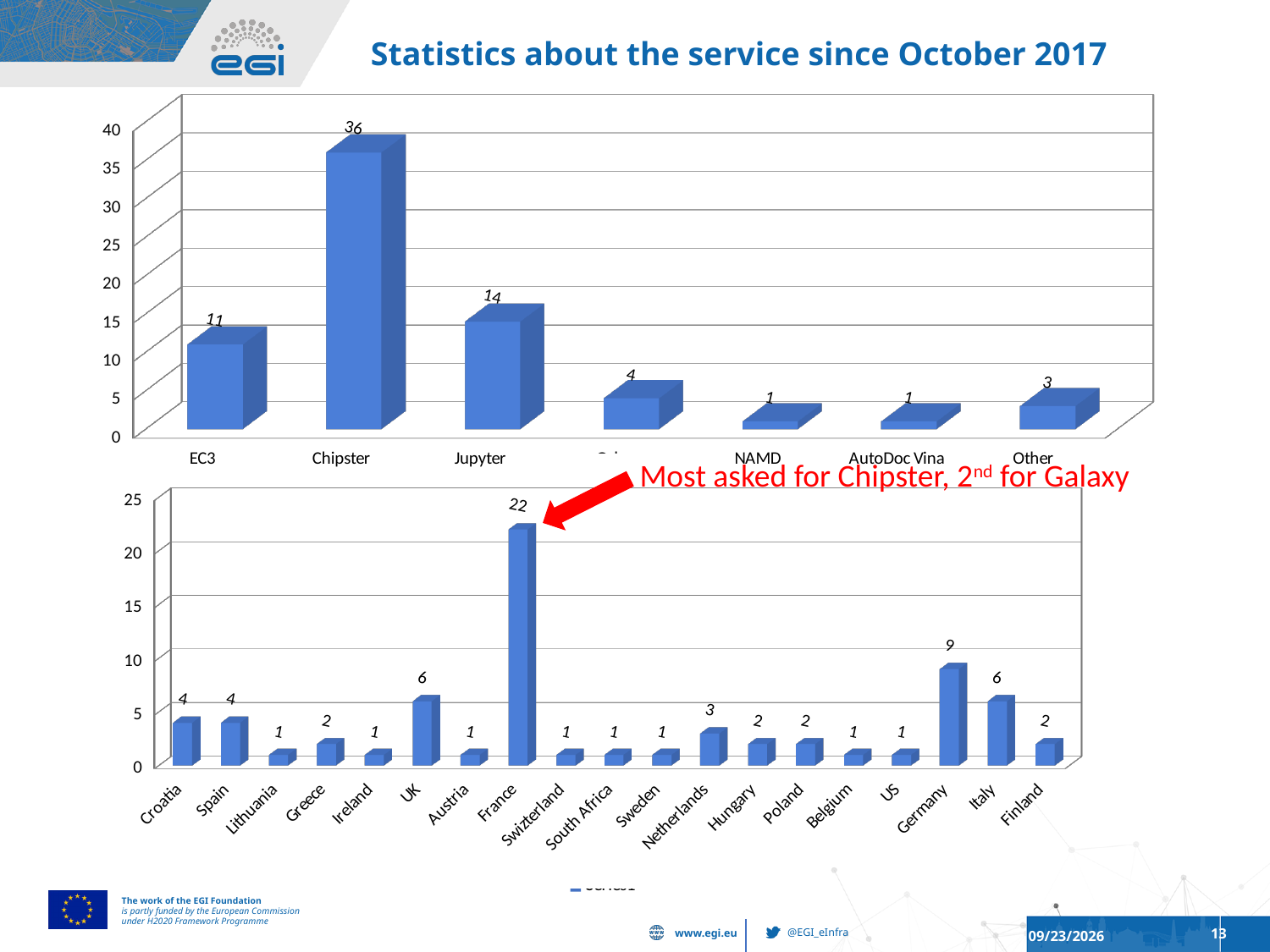
In the top chart, which is larger, the value for EC3 or the value for Jupyter? Jupyter In the top chart, what is the difference between the values for Chipster and EC3? 25 In the top chart, what is the value for Jupyter? 14 What type of chart is the bottom chart? Bar chart In the bottom chart, which country has the highest value? France In the top chart, which category has the highest value? Chipster In the bottom chart, what is the value for France? 22 In the bottom chart, what is the difference between the values for France and Germany? 13 In the bottom chart, what is the value for Germany? 9 In the top chart, what is the value for Chipster? 36 In the bottom chart, how many countries are shown on the x axis? 19 In the top chart, how many categories are shown on the x axis? 7